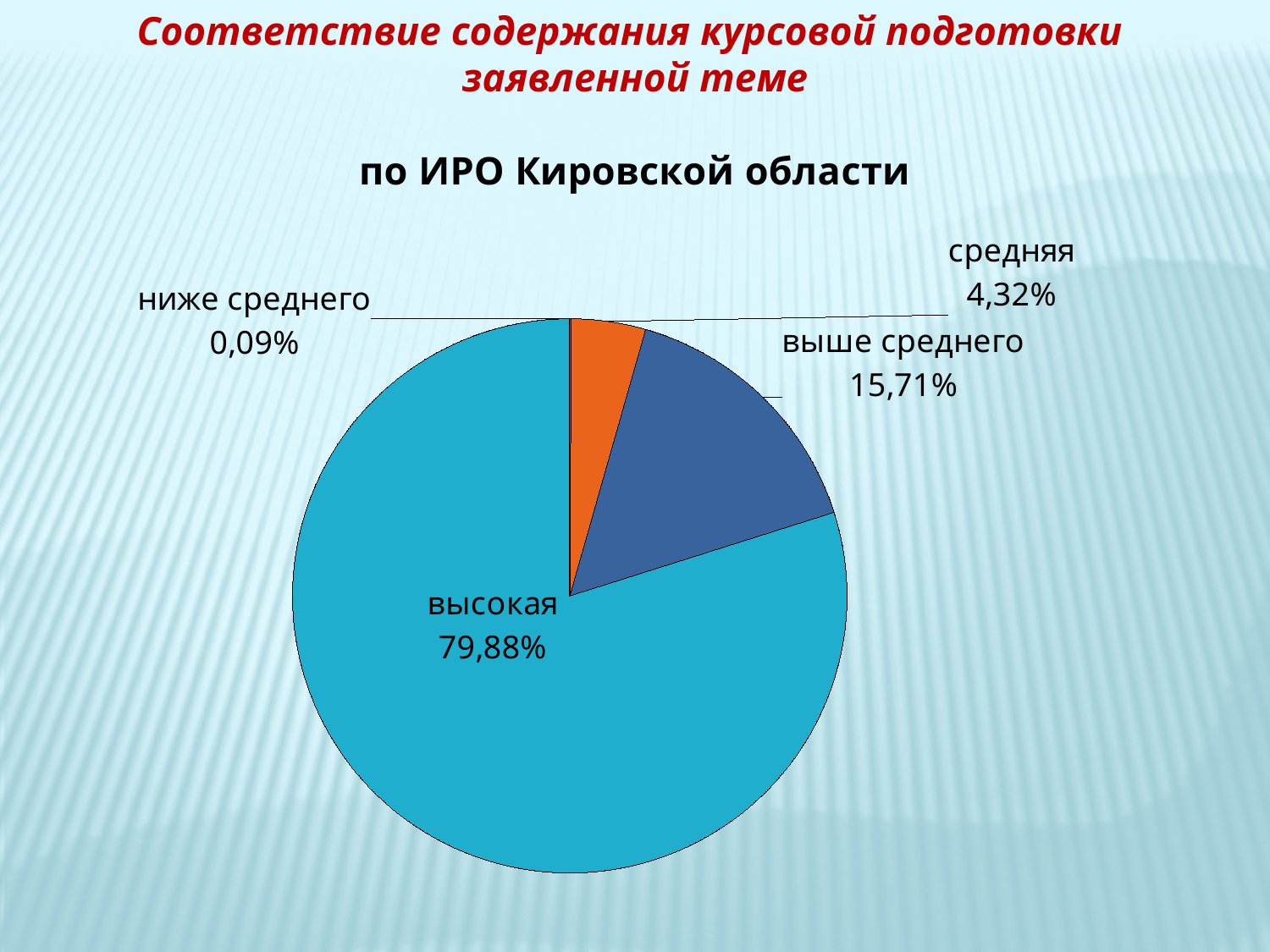
What is the difference between the values for "высокая" and "выше среднего"? 64,17% What kind of chart is shown on the slide? pie chart Which category has the smallest share of the pie? ниже среднего What is the value for "средняя"? 4,32% What is the value for "высокая"? 79,88% What is the value for "ниже среднего"? 0,09% What is the value for "выше среднего"? 15,71% Which category has the largest share of the pie? высокая How many slices does the pie chart have? 4 Which is larger, "выше среднего" or "средняя"? выше среднего What is the title of the chart? по ИРО Кировской области What is the difference between the values for "средняя" and "ниже среднего"? 4,23%